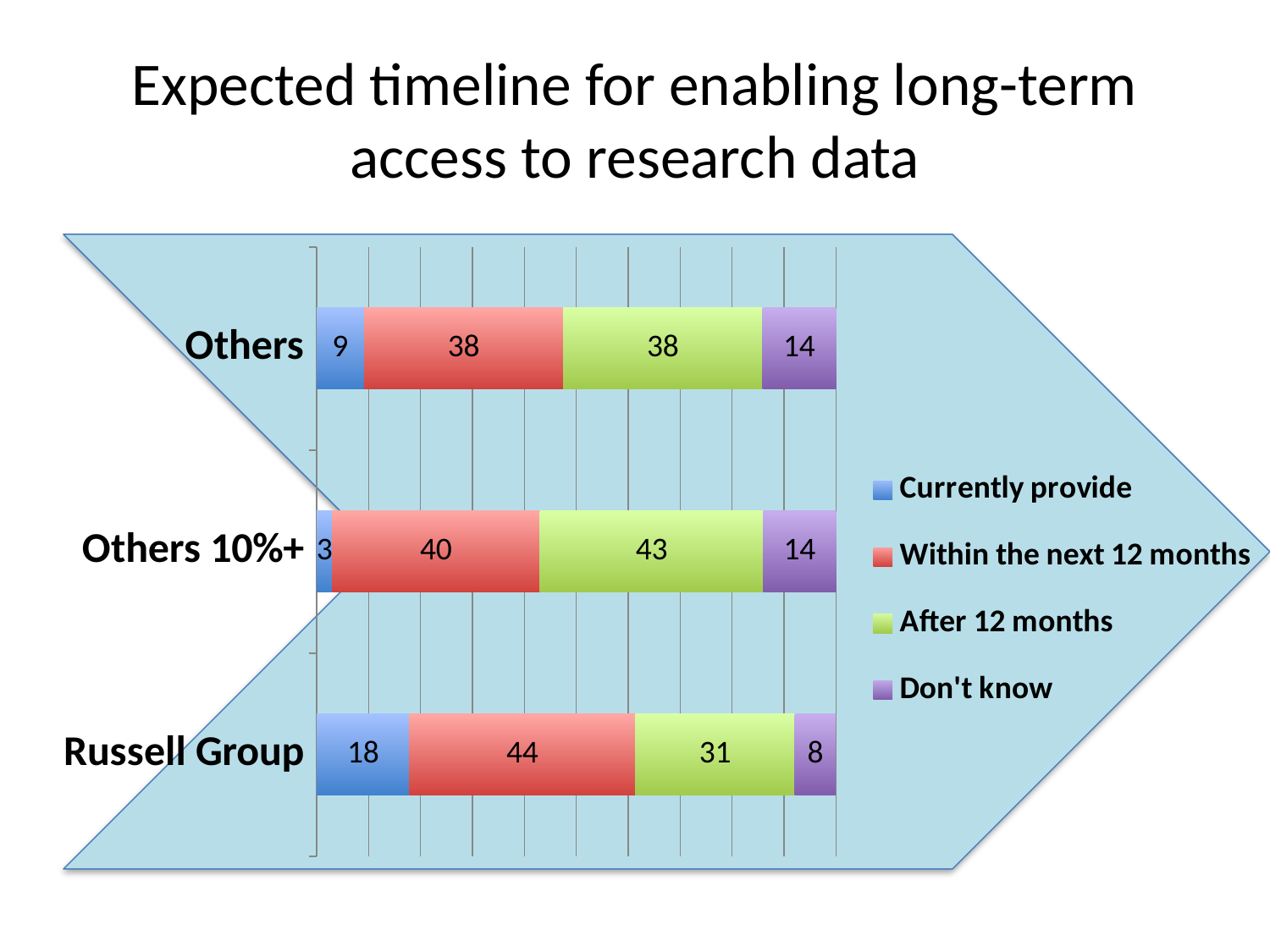
What is the value for 'After 12 months' for Others? 38 How many categories are plotted on the chart? 3 What is the value for 'Currently provide' for Russell Group? 18 What is the value for 'Don't know' for Russell Group? 8 Which category has the highest value for 'Currently provide'? Russell Group What is the value for 'Within the next 12 months' for Others 10%+? 40 How many series does the legend list? 4 What kind of chart is shown on the slide? Stacked bar chart Which category has the lowest value for 'Don't know'? Russell Group What is the difference between the 'After 12 months' values for Others 10%+ and Russell Group? 12 What is the total of the stacked bar for Russell Group? 101 Which is larger: the 'Within the next 12 months' value for Russell Group or for Others? Russell Group